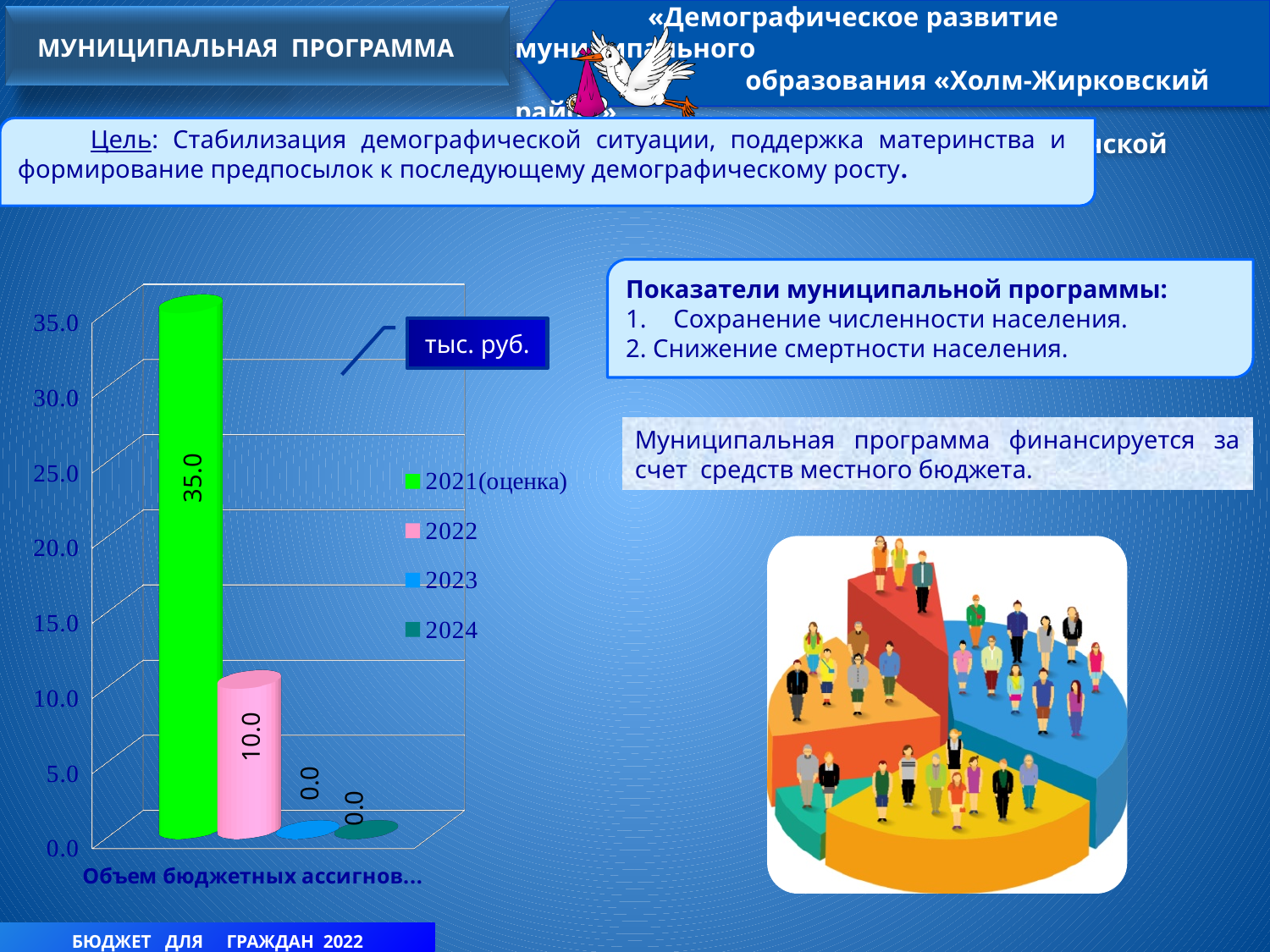
What kind of chart is shown on the slide? bar chart How many series does the chart legend list? 4 Which series has the highest value in the chart? 2021(оценка) What is the value for 2021(оценка) in the chart? 35.0 Is the value for 2021(оценка) greater or less than 30.0? greater Which is larger, the value for 2021(оценка) or the value for 2022? 2021(оценка) What is the value for 2023 in the chart? 0.0 What is the value for 2022 in the chart? 10.0 What is the difference between the values for 2021(оценка) and 2022? 25.0 What is the value for 2024 in the chart? 0.0 What unit of measurement is shown in the box next to the chart? тыс. руб. Is the value for 2022 greater or less than 15.0? less